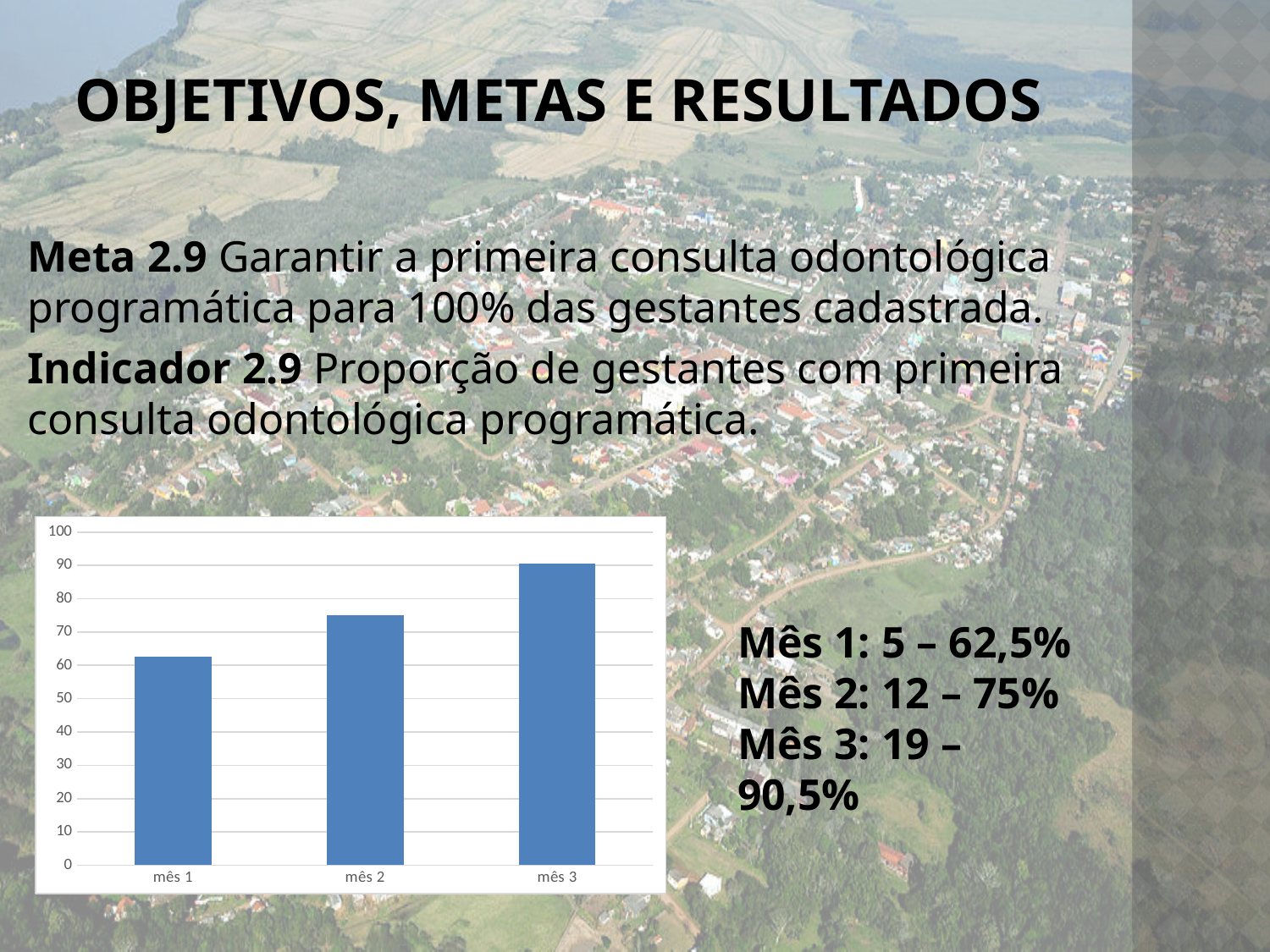
What kind of chart is shown on the slide? bar chart Is the value for mês 2 greater or less than 60? greater Which month has the highest bar in the chart? mês 3 Which is larger, the bar for mês 2 or the bar for mês 3? mês 3 What is the maximum value shown on the chart's vertical axis? 100 According to the text beside the chart, what proportion is reported for Mês 2? 75% How many categories are shown on the x axis of the chart? 3 Is the value for mês 1 greater or less than 50? greater Do the values rise or fall from mês 1 to mês 3? rise Is the value for mês 1 greater or less than 70? less Which month has the lowest bar in the chart? mês 1